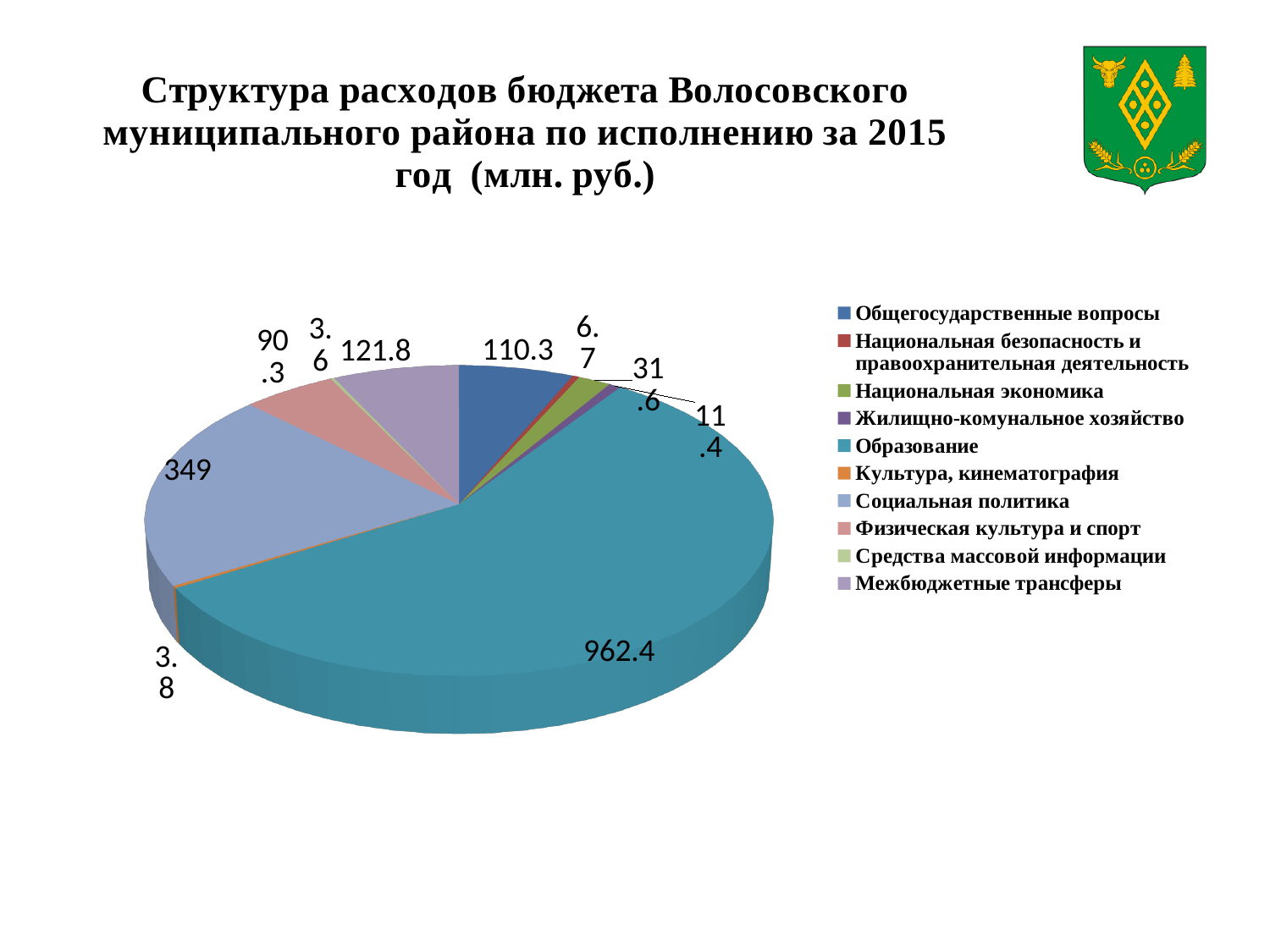
Which category has the largest slice of the pie chart? Образование What is the value for Общегосударственные вопросы on the pie chart? 110.3 In what units are the values on the chart given, according to the title? млн. руб. What kind of chart is shown on the slide? Pie chart What is the value for Физическая культура и спорт on the pie chart? 90.3 Which is larger: Социальная политика or Межбюджетные трансферы? Социальная политика What is the value for Образование on the pie chart? 962.4 What is the value for Межбюджетные трансферы on the pie chart? 121.8 How many entries does the legend list? 10 What is the difference between the values for Образование and Социальная политика? 613.4 What is the value for Социальная политика on the pie chart? 349 How many categories does the pie chart show? 10